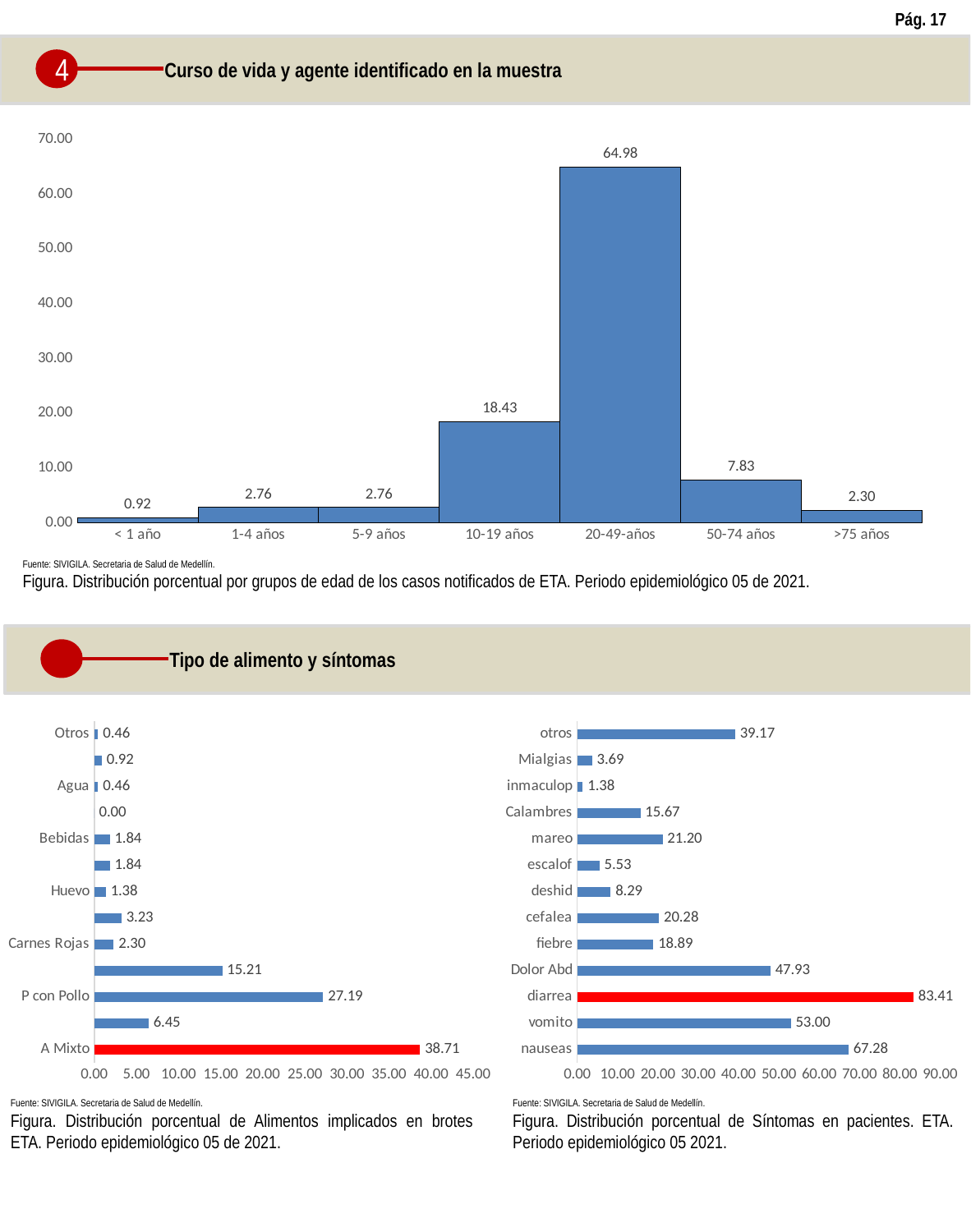
In the bottom-left chart (Alimentos implicados en brotes ETA), what is the value for P con Pollo? 27.19 In the bottom-right chart (Síntomas en pacientes), what is the value for vomito? 53.00 In the top chart (age groups of ETA cases), which age group has the highest value? 20-49-años In the bottom-left chart (Alimentos implicados en brotes ETA), which category has the highest value? A Mixto In the top chart (age groups of ETA cases), which age group has the lowest value? < 1 año In the bottom-left chart (Alimentos implicados en brotes ETA), which is larger, Carnes Rojas or Huevo? Carnes Rojas In the top chart (age groups of ETA cases), what is the value for the 20-49-años group? 64.98 In the bottom-right chart (Síntomas en pacientes), what is the difference between the values for diarrea and nauseas? 16.13 What kind of chart is the top chart (age groups of ETA cases)? Bar chart In the top chart (age groups of ETA cases), how many age groups are shown? 7 In the bottom-right chart (Síntomas en pacientes), which symptom has the highest value? diarrea In the top chart (age groups of ETA cases), what is the difference between the values for 10-19 años and 50-74 años? 10.60